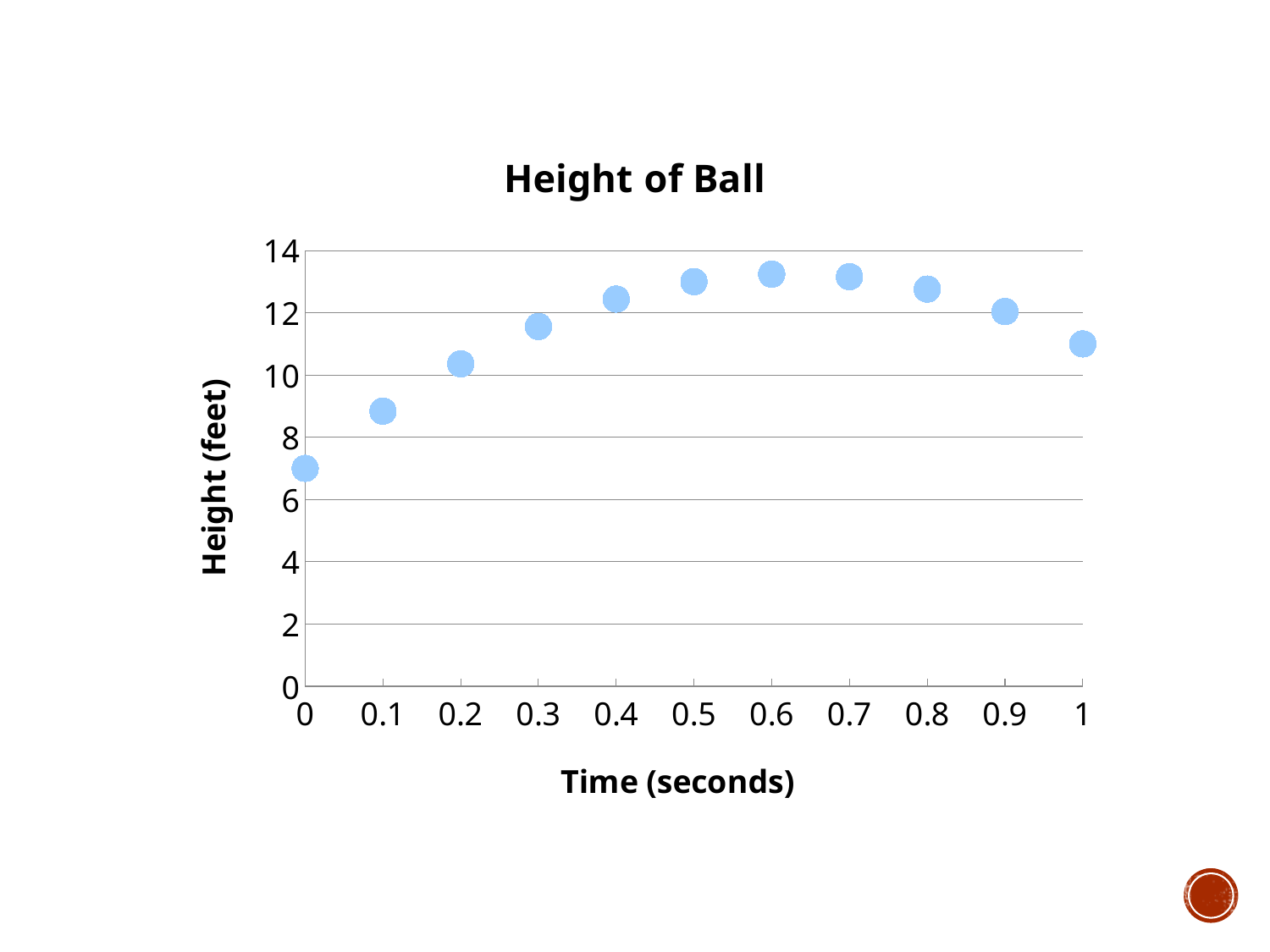
Is the height at time 0.1 greater or less than 8? greater Which is higher, the height at time 0 or the height at time 1? time 1 What is the title of the chart? Height of Ball Is the height at time 0 greater or less than 8? less How many data points are plotted on the chart? 11 Is the height at time 1 greater or less than 10? greater How does the height change as time increases from 0 to 1 second? rises then falls What is the label of the vertical axis? Height (feet) What kind of chart is shown on the slide? scatter chart At which time is the height of the ball lowest? 0